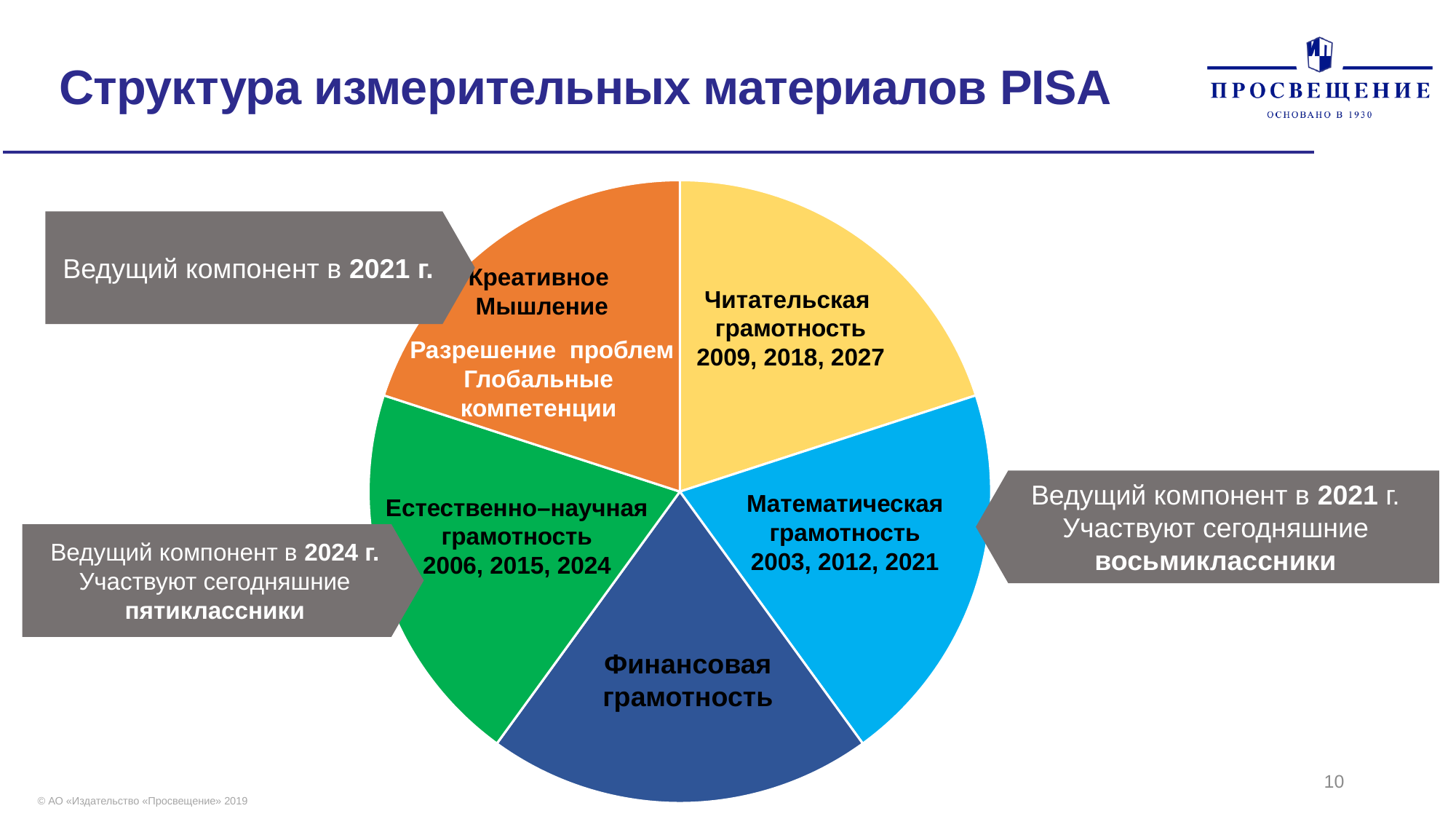
In which year is Естественно–научная грамотность the leading component according to the callout next to the chart? 2024 Which years are listed in the slice labelled Читательская грамотность? 2009, 2018, 2027 Which slice is labelled with the years 2009, 2018, 2027? Читательская грамотность What colour is the slice labelled Финансовая грамотность? dark blue How many slices does the pie chart have? 5 Which slice of the pie chart is coloured orange? Креативное мышление / Разрешение проблем / Глобальные компетенции What kind of chart is shown on the slide? pie chart Which slice is labelled with the years 2003, 2012, 2021? Математическая грамотность Which years are listed in the slice labelled Математическая грамотность? 2003, 2012, 2021 Which years are listed in the slice labelled Естественно–научная грамотность? 2006, 2015, 2024